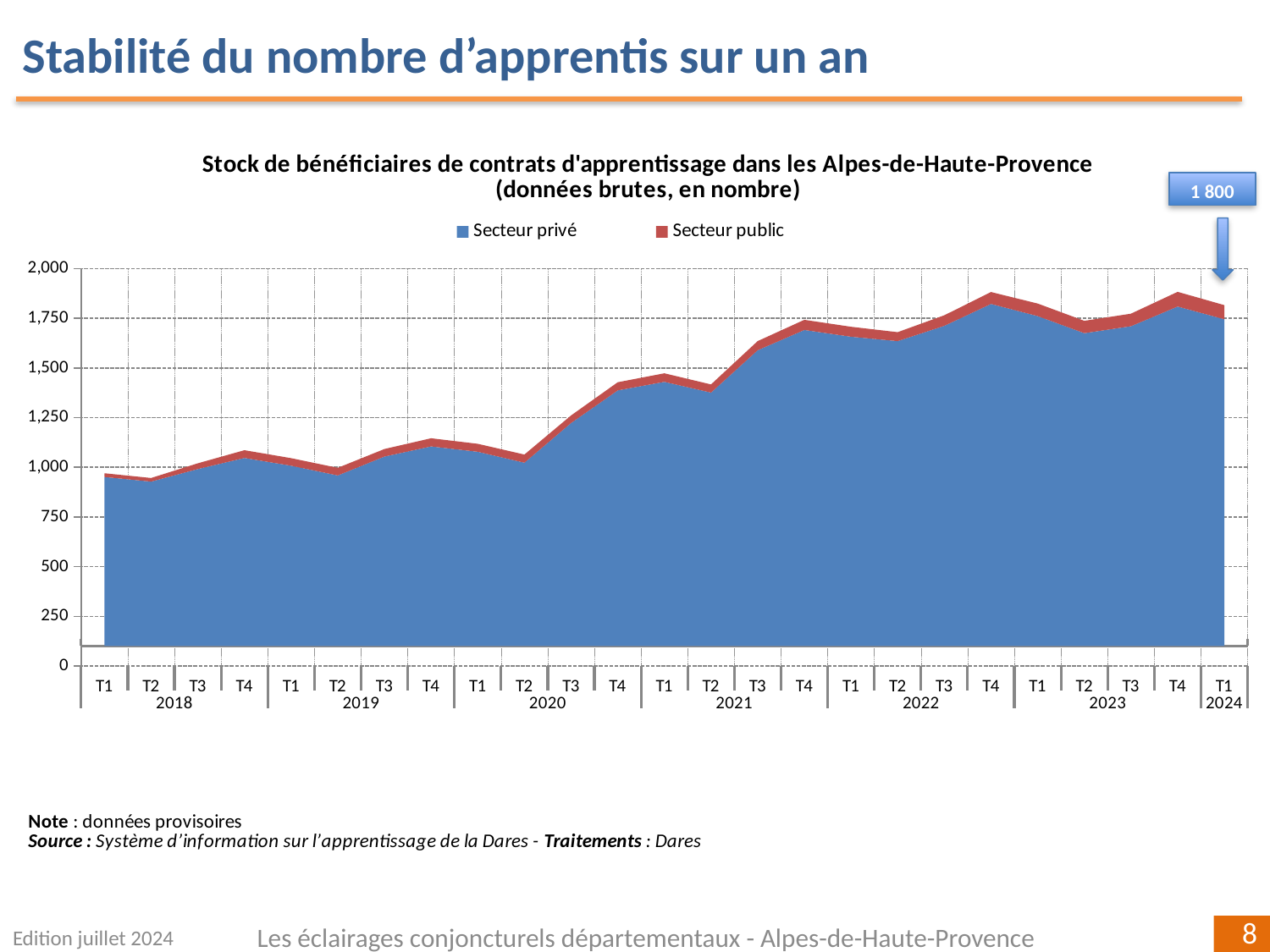
What total value is indicated by the callout for T1 2024? 1 800 Is the total value for T1 2018 greater or less than 1,000? less How many quarterly points are plotted along the x axis, from T1 2018 to T1 2024? 25 Is the total value for T4 2020 greater or less than 1,250? greater Is the total value for T4 2022 greater or less than 1,750? greater Which is larger, the total for T4 2022 or the total for T1 2018? T4 2022 What kind of chart is shown on the slide? area chart Which series accounts for the larger share of the stock, Secteur privé or Secteur public? Secteur privé How many series does the legend list? 2 Overall, do the values rise or fall from 2018 to 2024? rise What are the two series named in the legend? Secteur privé and Secteur public